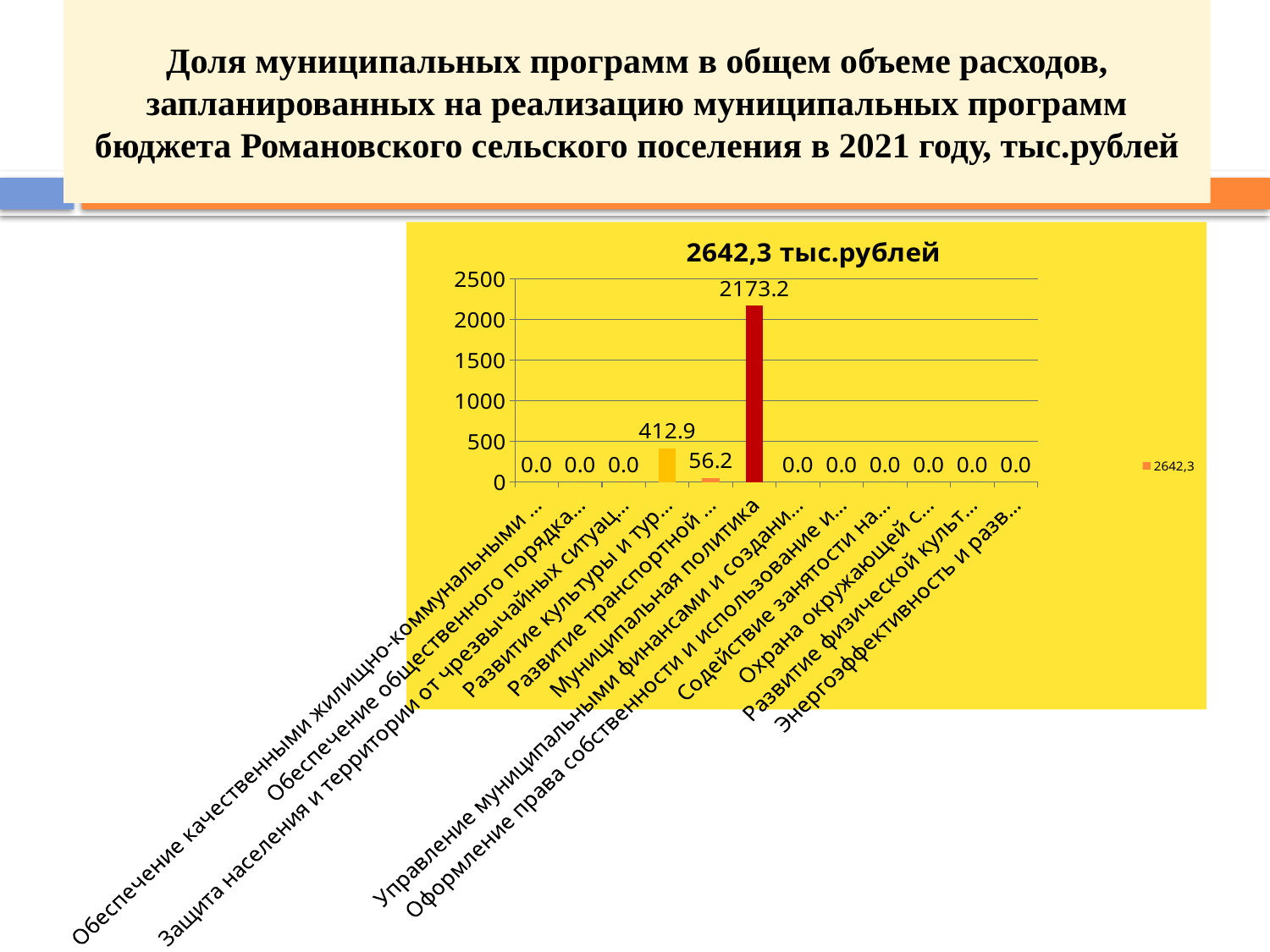
What is the difference between the values for the categories beginning "Развитие культуры" and "Развитие транспортной"? 356.7 Is the value for Муниципальная политика greater or less than 2000? greater How many series does the legend list? 1 What is the value for the category whose label begins "Развитие транспортной"? 56.2 What is the difference between the value for Муниципальная политика and the value for the category beginning "Развитие культуры"? 1760.3 How many categories are shown on the x axis? 12 What is the value for the category whose label begins "Развитие культуры"? 412.9 Which category has the highest value? Муниципальная политика What is the title of the chart? 2642,3 тыс.рублей What is the value for Муниципальная политика? 2173.2 Which is larger: the value for the category beginning "Развитие культуры" or the value for the category beginning "Развитие транспортной"? Развитие культуры What kind of chart is shown? bar chart